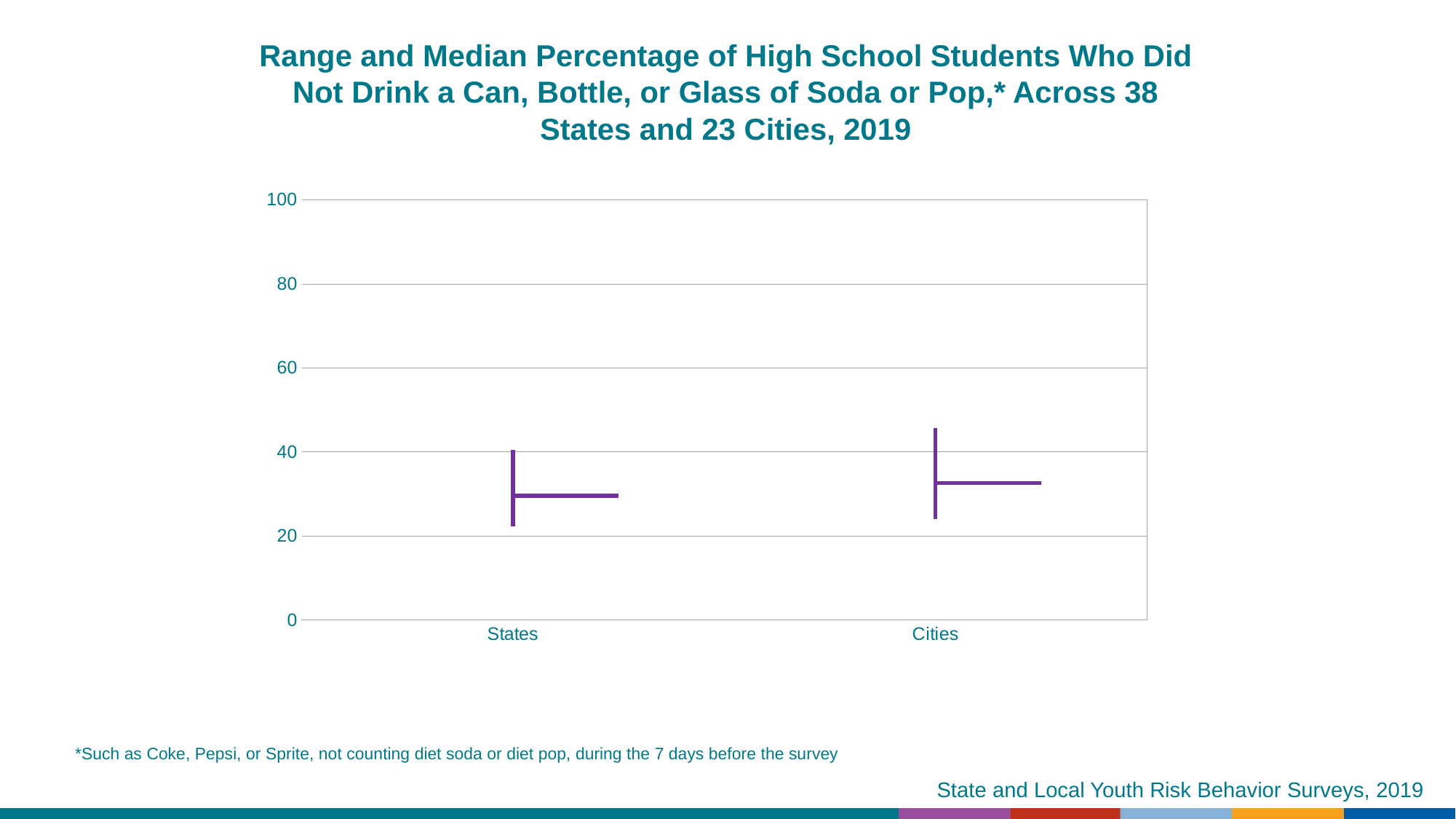
Is the bottom of the range for States greater or less than 20? greater What are the two categories shown on the x axis? States and Cities Is the median value for States greater or less than 40? less Which category has the higher top of its range, States or Cities? Cities Is the median value for Cities greater or less than 20? greater Which category has the higher median value, States or Cities? Cities How many categories are shown on the x axis of the chart? 2 What kind of chart is this? A range and median (high-low) chart What is the highest value shown on the y axis? 100